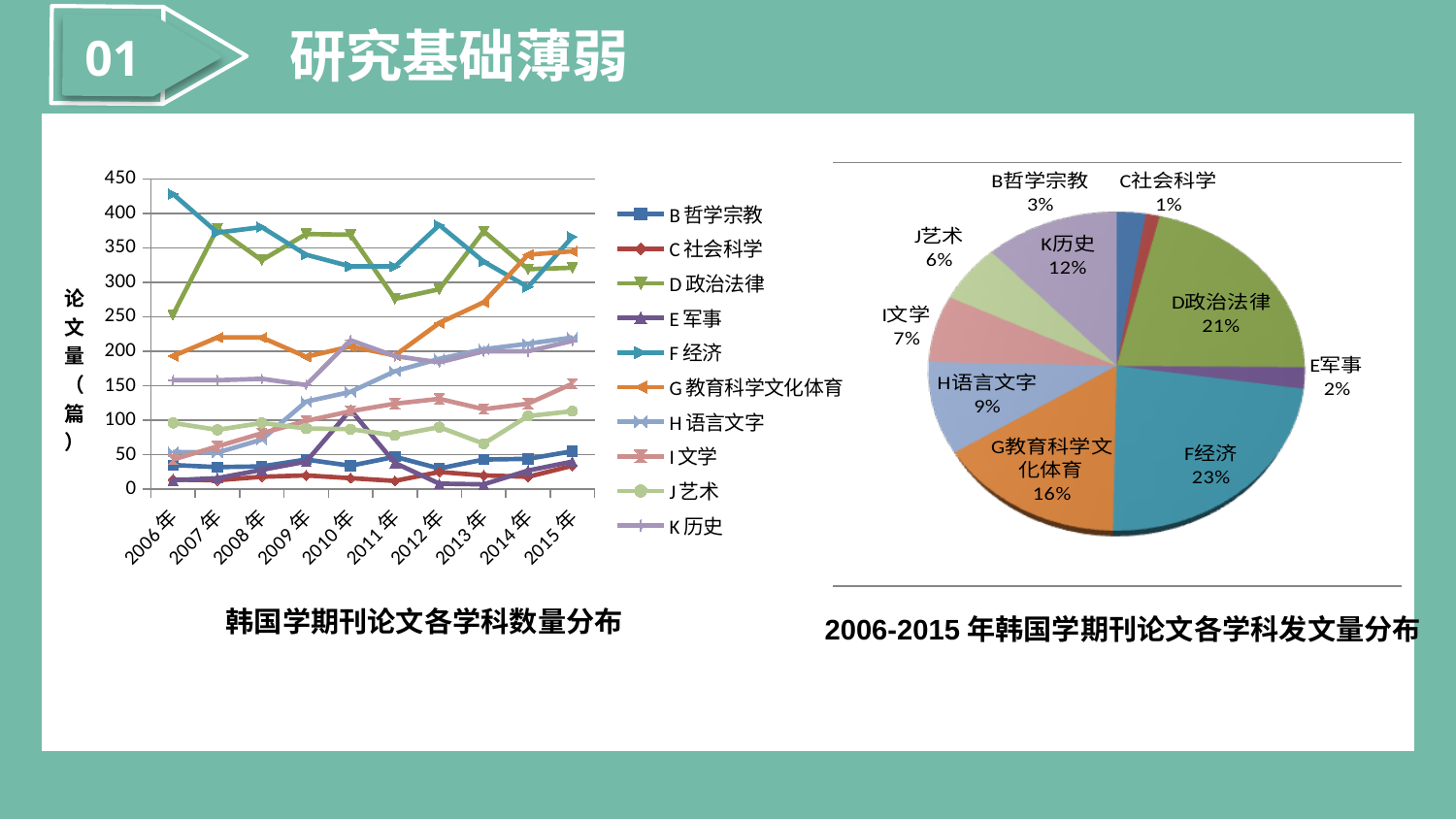
How many series does the legend of the line chart on the left list? 10 In the pie chart on the right, what share of the papers does F经济 account for? 23% What kind of chart is the chart on the left (韩国学期刊论文各学科数量分布)? Line chart In the pie chart on the right, which discipline has the smallest share? C社会科学 In the line chart on the left, which series has the higher value in 2006年: F经济 or D政治法律? F经济 How many slices does the pie chart on the right have? 10 In the pie chart on the right, how many percentage points larger is the share of D政治法律 than that of G教育科学文化体育? 5 percentage points In the line chart on the left, is the value for D政治法律 in 2006年 greater or less than 300? less How many years are shown on the x axis of the line chart on the left? 10 In the line chart on the left, is the value for F经济 in 2006年 greater or less than 400? greater In the pie chart on the right, what is the share for K历史? 12% In the pie chart on the right, which discipline has the largest share? F经济